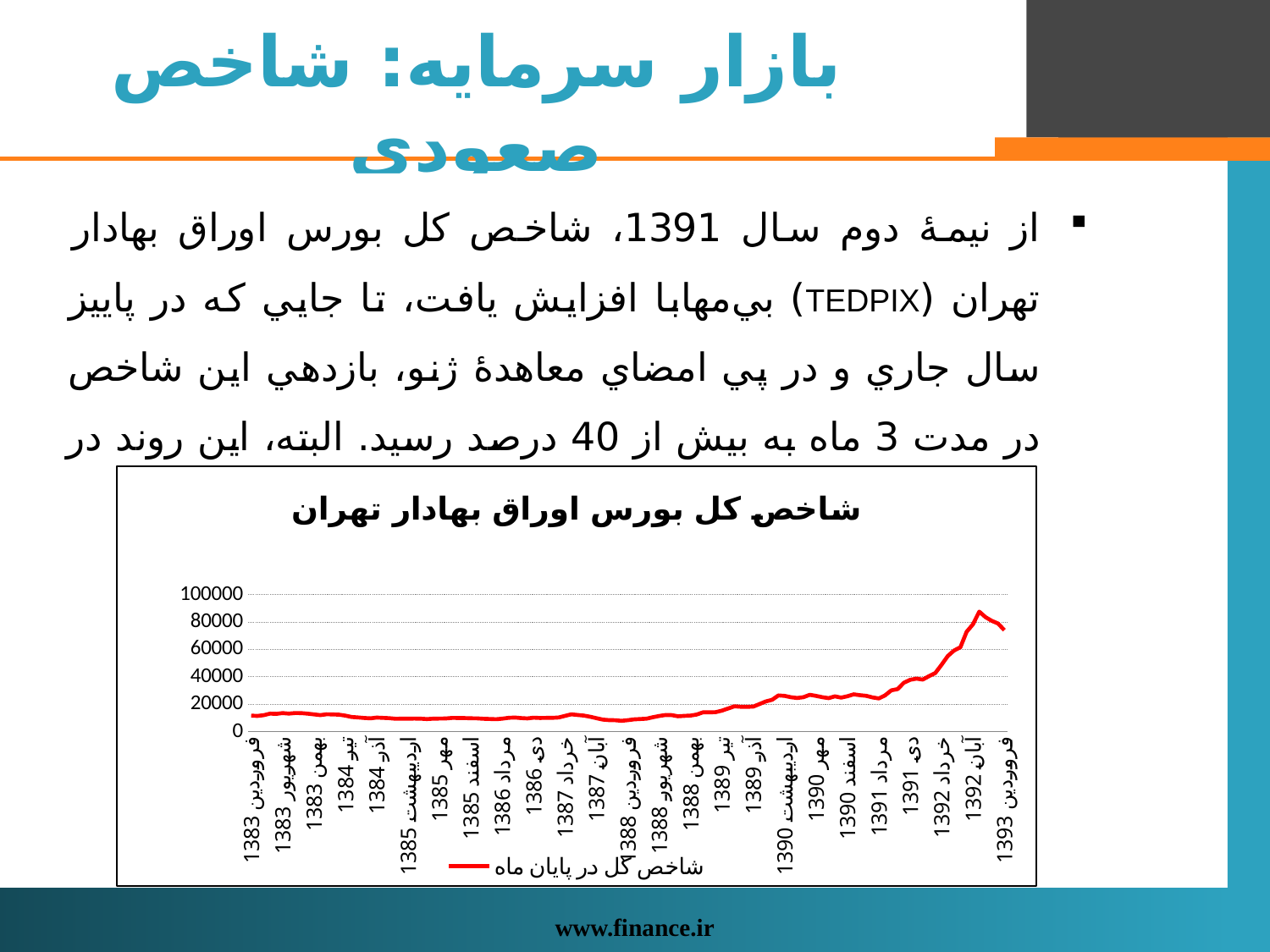
Overall, does the index rise or fall from فروردین 1383 to فروردین 1393? rise Which is larger, the value for فروردین 1393 or the value for فروردین 1383? فروردین 1393 Is the value for فروردین 1383 greater or less than 20000? less What is the title of the chart? شاخص کل بورس اوراق بهادار تهران Is the value for فروردین 1388 greater or less than 20000? less What kind of chart is shown on the slide? line chart After reaching its peak near آبان 1392, does the line rise or fall toward فروردین 1393? fall What is the legend entry for the plotted line? شاخص کل در پایان ماه Is the value for فروردین 1393 greater or less than 60000? greater What is the highest value shown on the y axis? 100000 How many series does the chart legend list? 1